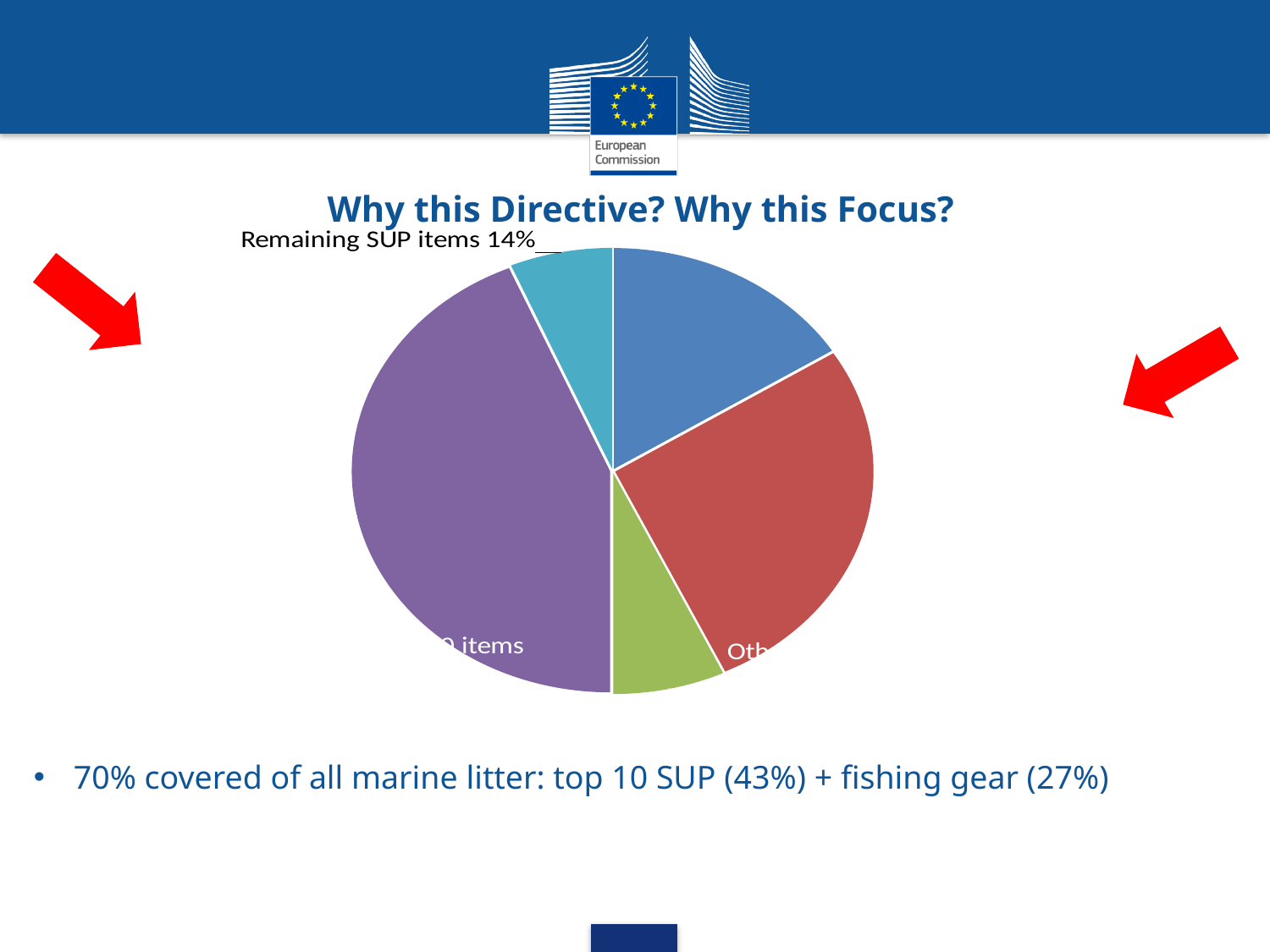
What kind of chart is shown on the slide? pie chart How many slices does the pie chart have? 5 Which slice of the pie chart is the largest? the purple slice What is the title shown above the pie chart? Why this Directive? Why this Focus? What share of the pie is labelled 'Remaining SUP items'? 14% What colour is the 'Remaining SUP items' slice? teal (light blue)